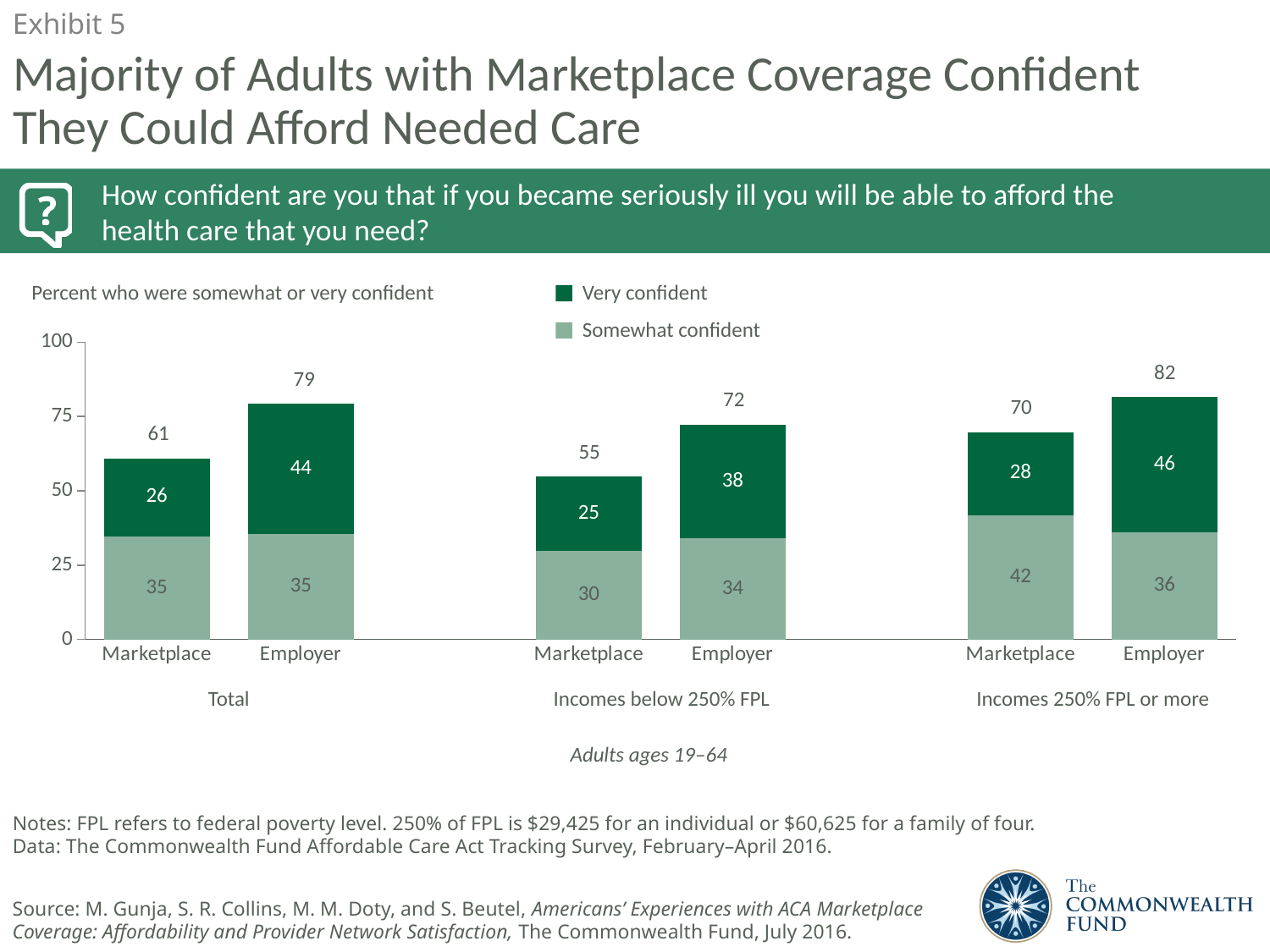
How many series does the legend list? 2 What is the total percent somewhat or very confident for Marketplace coverage in the Total group? 61 What is the difference between the Employer and Marketplace totals in the Total group? 18 What is the 'Somewhat confident' value for Marketplace coverage among adults with incomes below 250% FPL? 30 In the Incomes 250% FPL or more group, which is larger: the 'Somewhat confident' value for Marketplace or for Employer? Marketplace How many bars are plotted on the chart? 6 What is the 'Very confident' value for Employer coverage among adults with incomes 250% FPL or more? 46 What is the total of the stacked bar for Employer coverage among adults with incomes below 250% FPL? 72 Which bar has the lowest total percent somewhat or very confident? Marketplace, Incomes below 250% FPL Which colour represents 'Very confident' in the legend? Dark green Which bar has the highest total percent somewhat or very confident? Employer, Incomes 250% FPL or more What kind of chart is shown on the slide? Stacked bar chart